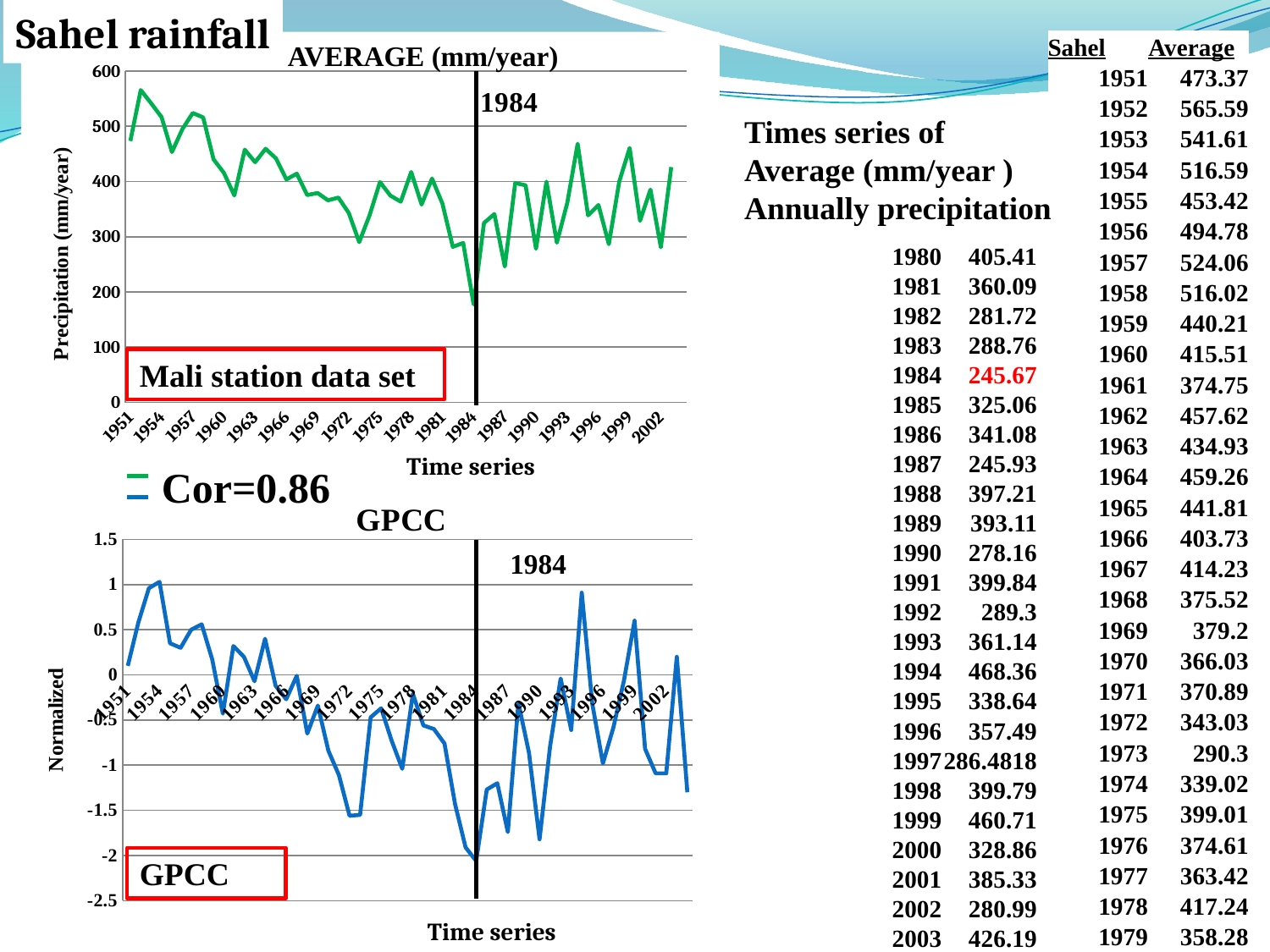
In the top chart 'AVERAGE (mm/year)', is the value for 1984 greater or less than 300? less In the bottom chart 'GPCC', is the value for 1954 greater or less than 0.5? greater In the top chart 'AVERAGE (mm/year)', which is larger, the value for 1952 or the value for 1984? 1952 In the top chart 'AVERAGE (mm/year)', is the value for 1952 greater or less than 500? greater What is the y-axis label of the top chart 'AVERAGE (mm/year)'? Precipitation (mm/year) In the top chart 'AVERAGE (mm/year)', do the values generally rise or fall from 1951 to 1984? fall In the bottom chart 'GPCC', which year has the lowest normalized value? 1984 What kind of chart is the top chart titled 'AVERAGE (mm/year)'? line chart Which year is marked by the vertical black line in both charts? 1984 What kind of chart is the bottom chart titled 'GPCC'? line chart In the top chart 'AVERAGE (mm/year)', which year has the lowest precipitation? 1984